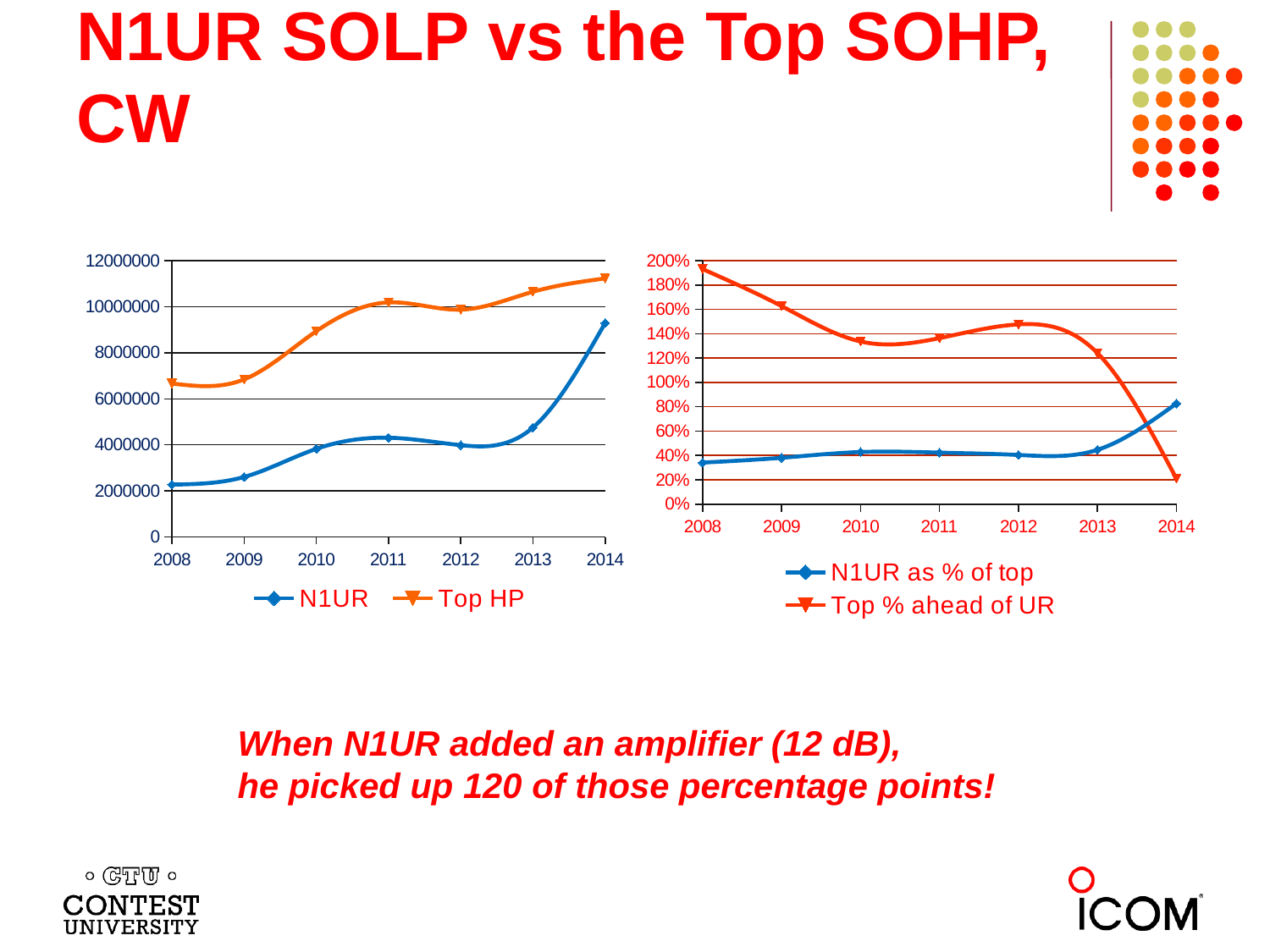
In the right chart, is the value for Top % ahead of UR in 2014 greater or less than 40%? less In the right chart, in which year is the Top % ahead of UR series at its lowest? 2014 In the left chart, which series has the higher value in 2010, N1UR or Top HP? Top HP In the left chart, is the value for N1UR in 2014 greater or less than 8000000? greater In the left chart, is the value for Top HP in 2014 greater or less than 10000000? greater How many years are plotted along the x axis of the left chart? 7 How many series does the legend of the right chart list? 2 In the right chart, does the Top % ahead of UR series generally rise or fall from 2008 to 2014? fall What kind of chart is the left chart on the slide? Line chart In the left chart, what are the two legend entries? N1UR and Top HP In the right chart, in which year is the Top % ahead of UR series at its highest? 2008